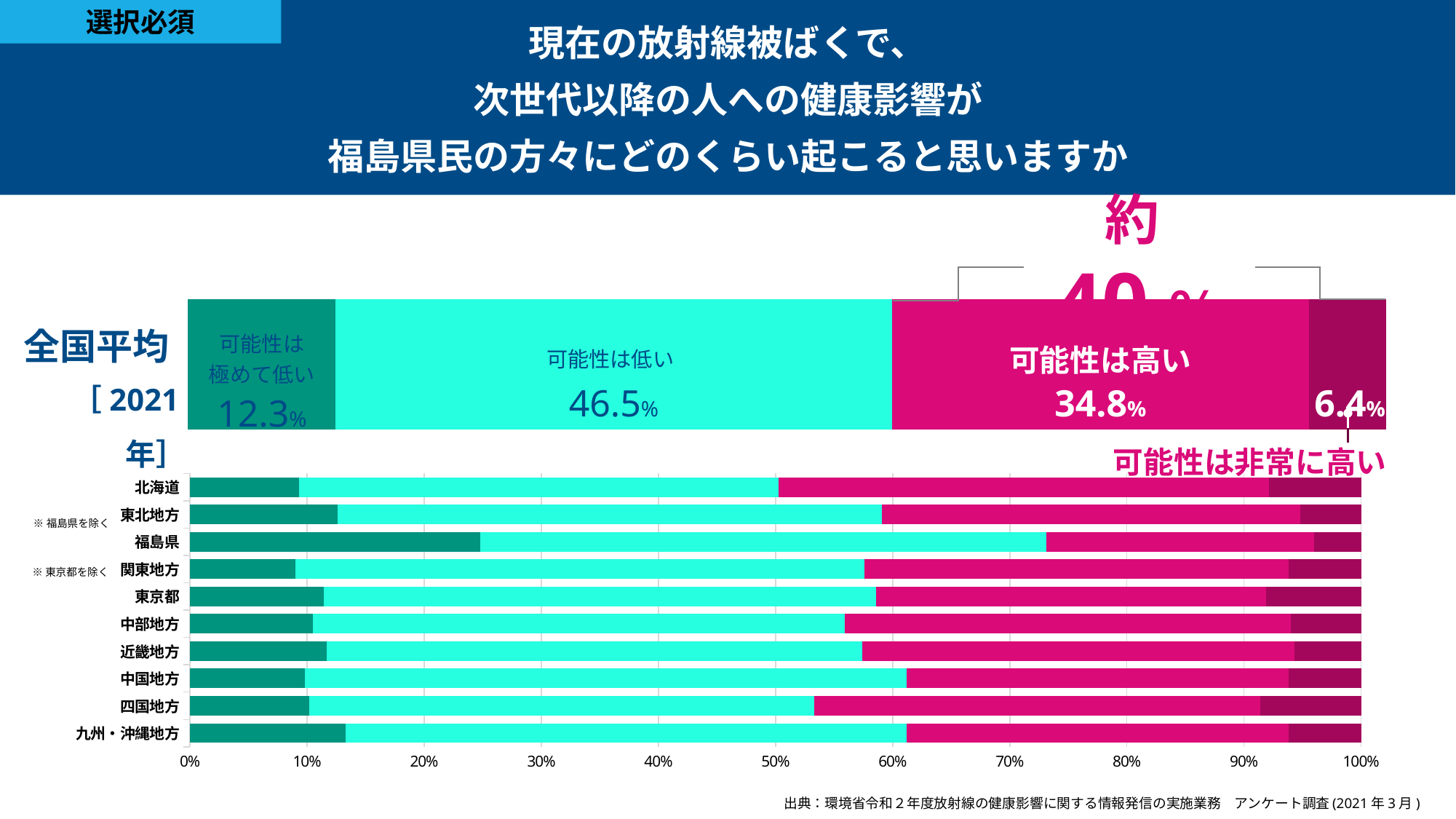
What kind of chart is the regional chart at the bottom of the slide? Stacked horizontal bar chart How many regions are listed in the regional bar chart at the bottom of the slide? 10 In the national average (全国平均) bar, which is larger: 可能性は高い or 可能性は極めて低い? 可能性は高い In the national average (全国平均) bar, what is the value for 可能性は極めて低い? 12.3% In the regional chart, is the 可能性は極めて低い (dark green) segment for 福島県 greater or less than 20%? greater In the national average (全国平均) bar, what is the value for 可能性は低い? 46.5% In the national average (全国平均) bar, which segment is the largest? 可能性は低い In the regional chart, which region has the largest 可能性は極めて低い (dark green) segment? 福島県 In the national average (全国平均) bar, what is the difference between 可能性は低い and 可能性は高い? 11.7 percentage points According to the annotation above the national average bar, roughly what combined share do 可能性は高い and 可能性は非常に高い make up? 約40% In the national average (全国平均) bar, which segment is the smallest? 可能性は非常に高い In the national average (全国平均) bar, what is the value for 可能性は非常に高い? 6.4%